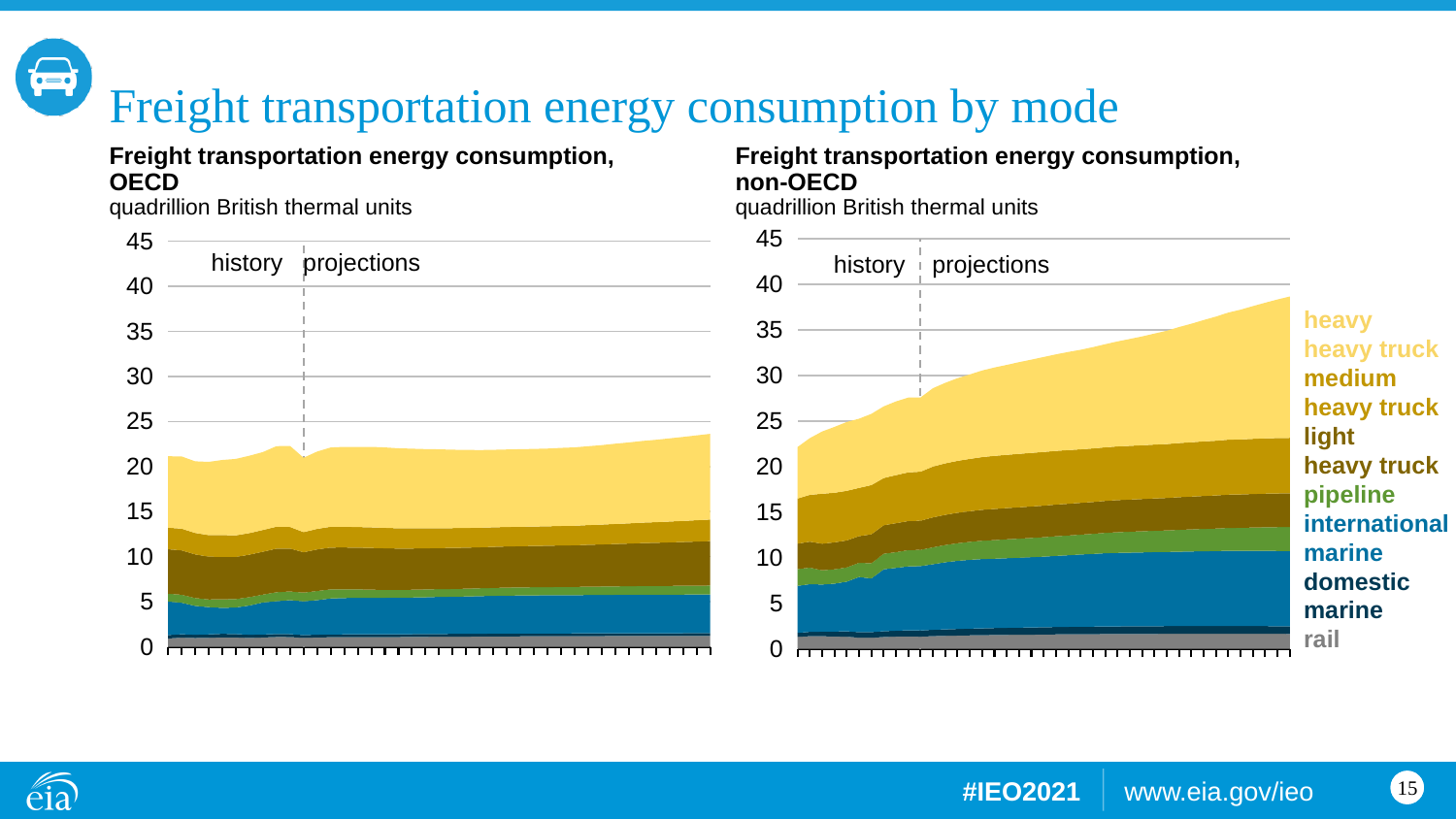
In the 'Freight transportation energy consumption, non-OECD' chart, is the total at the start of the history period greater or less than 20? greater In the 'Freight transportation energy consumption, OECD' chart, which mode accounts for the largest share of consumption at the end of the projection period? heavy heavy truck In the 'Freight transportation energy consumption, OECD' chart, is the total at the end of the projection period greater or less than 25? less What unit is used on the y axis of both freight transportation energy consumption charts? quadrillion British thermal units In the 'Freight transportation energy consumption, non-OECD' chart, is the total at the end of the projection period greater or less than 35? greater What kind of chart is the 'Freight transportation energy consumption, OECD' chart? stacked area chart In the 'Freight transportation energy consumption, non-OECD' chart, which mode accounts for the largest share of consumption at the end of the projection period? heavy heavy truck How many series does the legend list for the freight transportation energy consumption charts? 7 What is the maximum value shown on the y axis of the 'Freight transportation energy consumption, OECD' chart? 45 In the 'Freight transportation energy consumption, non-OECD' chart, do total values rise or fall along the x axis? rise Which chart shows the higher total freight transportation energy consumption at the end of the projection period, OECD or non-OECD? non-OECD